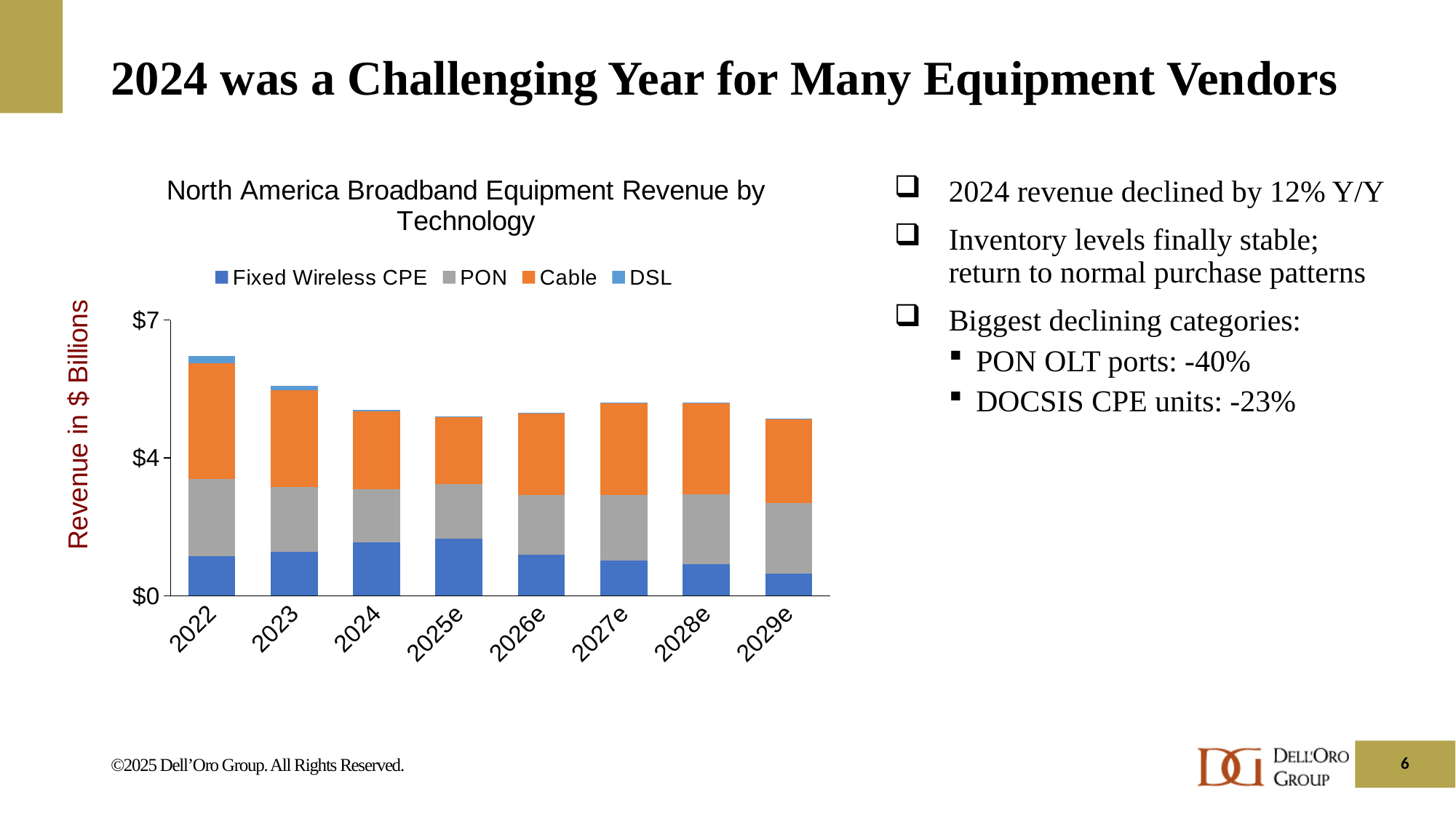
In which year is the Fixed Wireless CPE segment the largest? 2025e How many series does the chart's legend list? 4 Which year has the highest total broadband equipment revenue in the chart? 2022 Does total revenue rise or fall from 2022 to 2024? fall How many years (categories) are shown on the x axis of the chart? 8 What is the label of the vertical axis of the chart? Revenue in $ Billions Which year has a larger total revenue, 2022 or 2024? 2022 What type of chart is shown on the slide? Stacked bar chart Is the total revenue for 2022 greater or less than $4 billion? greater Is the total revenue for 2022 greater or less than $7 billion? less What is the title of the chart? North America Broadband Equipment Revenue by Technology Is the total revenue for 2029e greater or less than $4 billion? greater